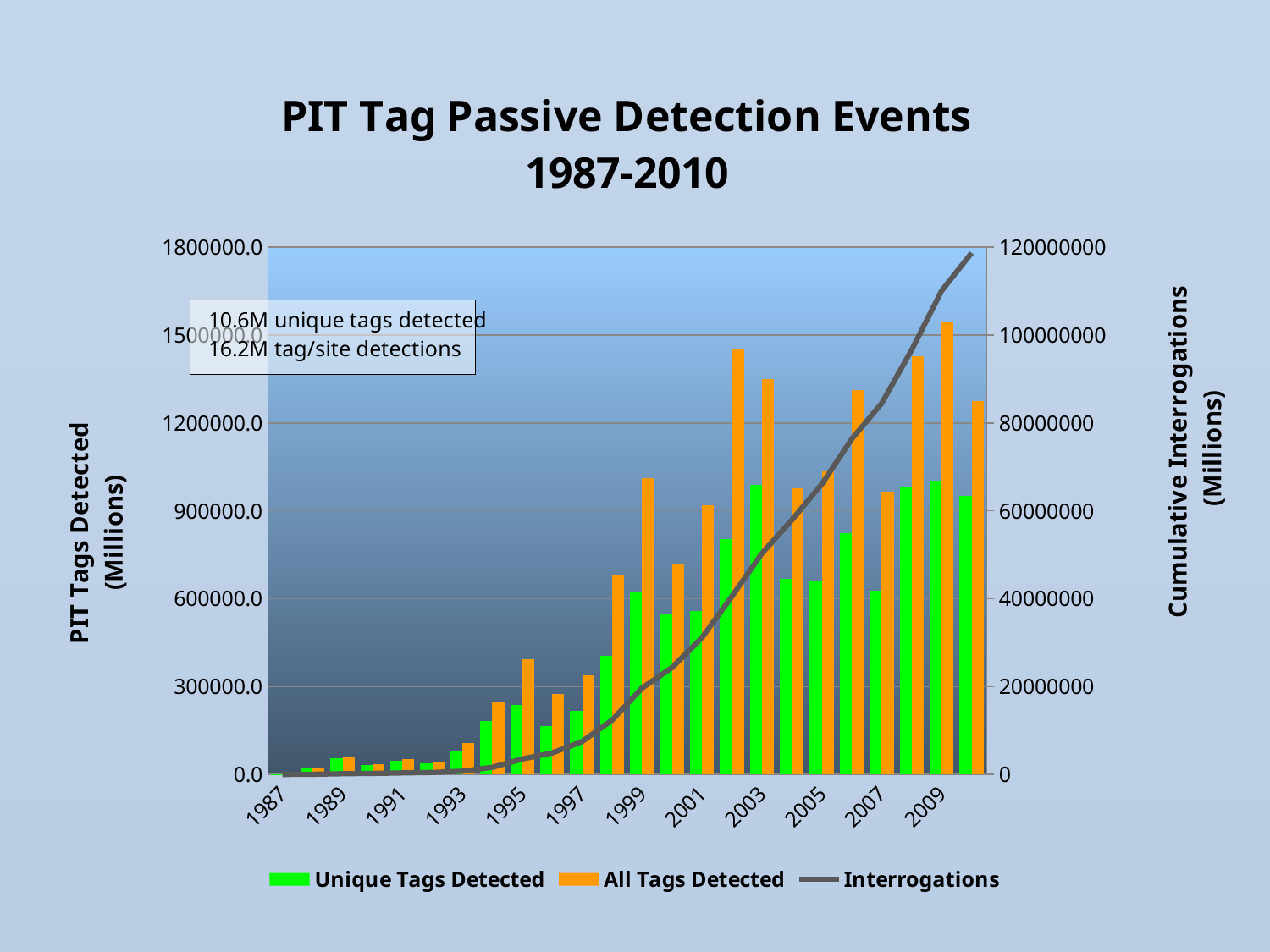
Is the value for Interrogations in 2005 greater or less than 60000000? greater Is the value for Unique Tags Detected in 1997 greater or less than 300000.0? less Which is larger, All Tags Detected in 2003 or All Tags Detected in 2005? 2003 What are the three series listed in the legend? Unique Tags Detected, All Tags Detected, Interrogations What is the title of the chart? PIT Tag Passive Detection Events 1987-2010 Is the value for Unique Tags Detected in 2003 greater or less than 900000.0? greater Does the Interrogations line rise or fall from 1987 to 2010? Rises What kind of chart is shown on the slide? Combined bar and line chart How many series does the legend list? 3 Which is larger, Unique Tags Detected in 2007 or Unique Tags Detected in 2008? 2008